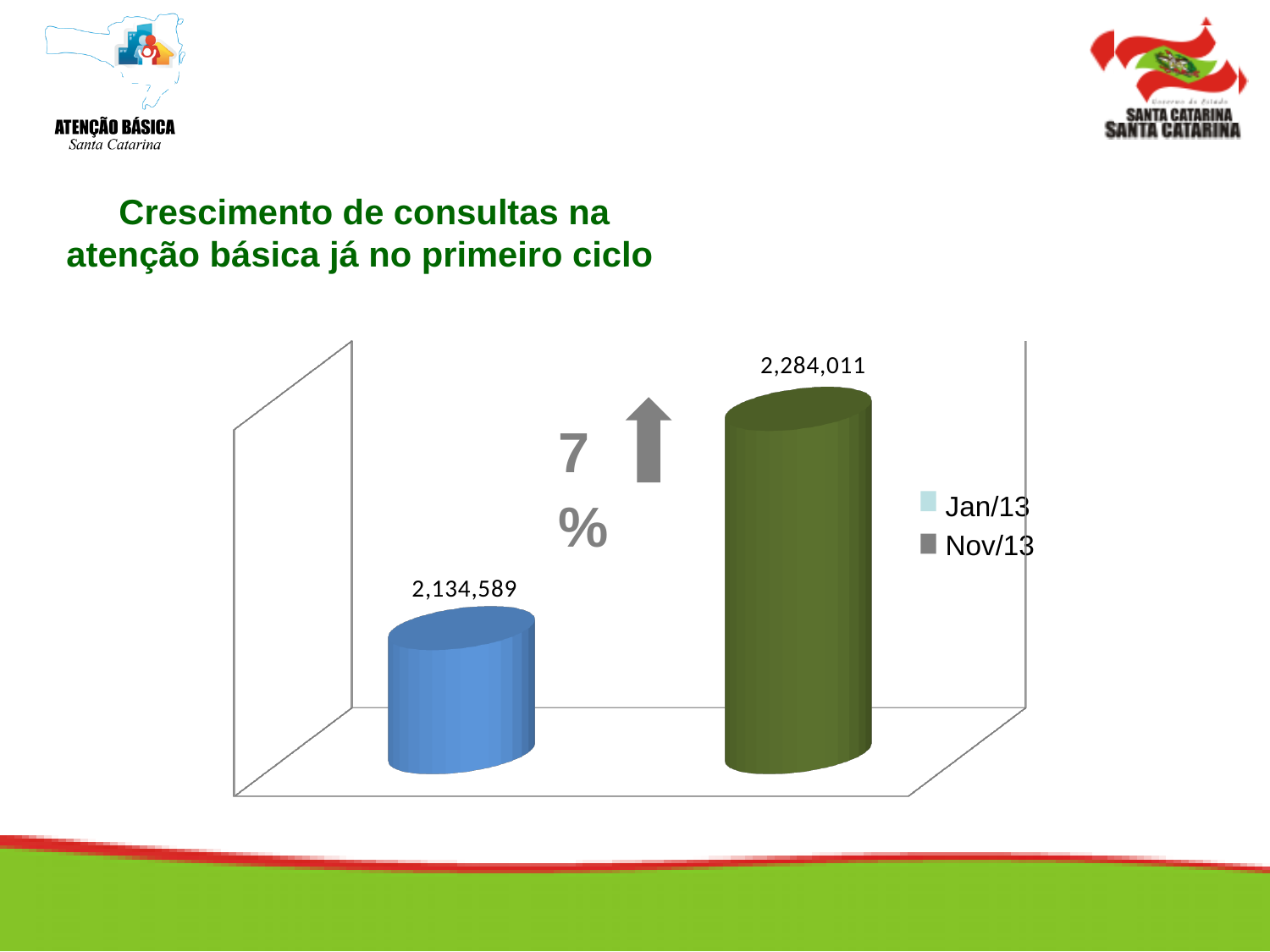
Which series has the higher value, Jan/13 or Nov/13? Nov/13 What percentage growth is printed next to the arrow between the two bars? 7 % Do the values rise or fall from Jan/13 to Nov/13? rise What is the difference between the Nov/13 value and the Jan/13 value? 149,422 What colour is the bar for Nov/13? green How many entries does the legend list? 2 What kind of chart is shown on the slide? bar chart What value is shown for Jan/13? 2,134,589 What value is shown for Nov/13? 2,284,011 Which series has the lower value? Jan/13 How many bars are plotted in the chart? 2 Is the value for Nov/13 larger or smaller than the value for Jan/13? larger